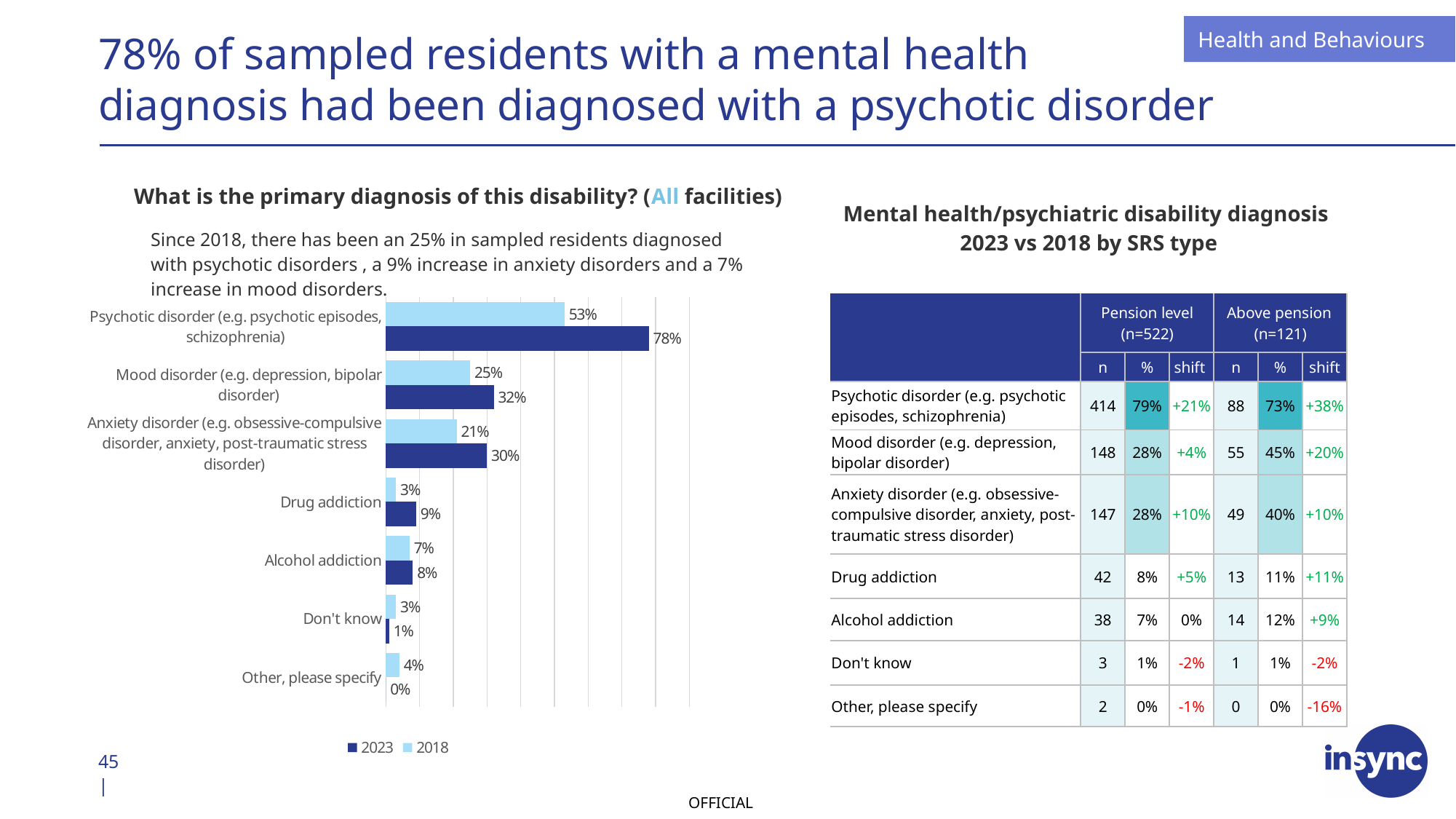
What is the 2023 value for Anxiety disorder in the bar chart? 30% What is the 2018 value for Mood disorder in the bar chart? 25% What is the 2023 value for Psychotic disorder in the bar chart? 78% What are the two series named in the bar chart's legend? 2023 and 2018 What is the difference between the 2023 and 2018 values for Psychotic disorder in the bar chart? 25% How many categories are shown in the bar chart? 7 How many series does the legend of the bar chart list? 2 Which category has the lowest 2023 value in the bar chart? Other, please specify What is the 2018 value for Alcohol addiction in the bar chart? 7% In the bar chart, which is larger for Drug addiction: the 2023 value or the 2018 value? 2023 What kind of chart is shown on the left of the slide? Bar chart Which category has the highest 2023 value in the bar chart? Psychotic disorder